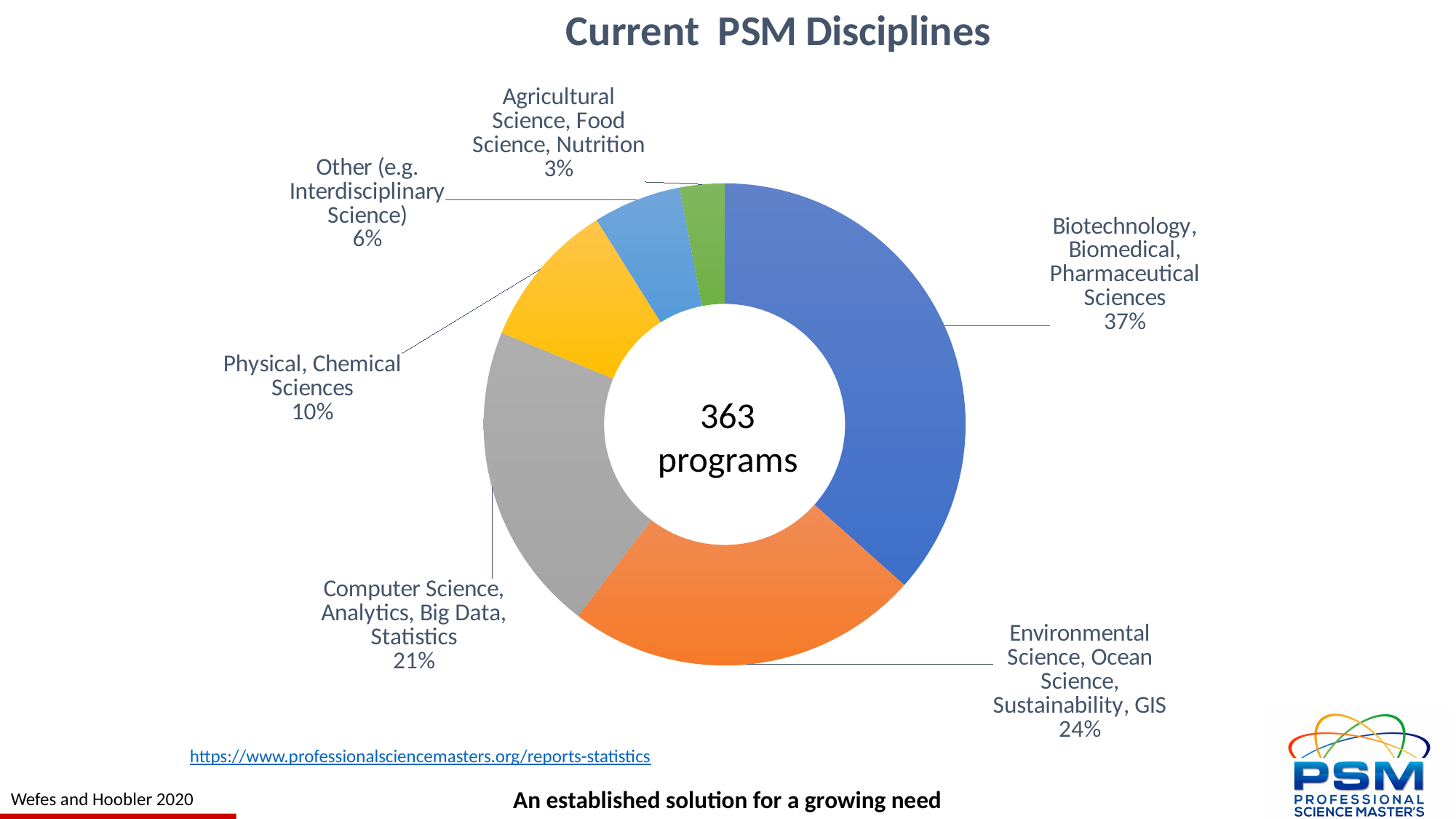
Which has a larger share: Computer Science, Analytics, Big Data, Statistics or Environmental Science, Ocean Science, Sustainability, GIS? Environmental Science, Ocean Science, Sustainability, GIS What share of PSM programs is in Agricultural Science, Food Science, Nutrition? 3% What is the title of the chart? Current PSM Disciplines What share of PSM programs is in Computer Science, Analytics, Big Data, Statistics? 21% Which discipline has the largest share of PSM programs? Biotechnology, Biomedical, Pharmaceutical Sciences What kind of chart is shown on the slide? Pie chart (doughnut) What is the difference in percentage points between the Environmental Science, Ocean Science, Sustainability, GIS share and the Physical, Chemical Sciences share? 14 How many discipline categories are shown in the chart? 6 What share of PSM programs is in Biotechnology, Biomedical, Pharmaceutical Sciences? 37% What is the share of the Other (e.g. Interdisciplinary Science) slice? 6% Which discipline has the smallest share of PSM programs? Agricultural Science, Food Science, Nutrition How many programs in total does the centre of the chart report? 363 programs